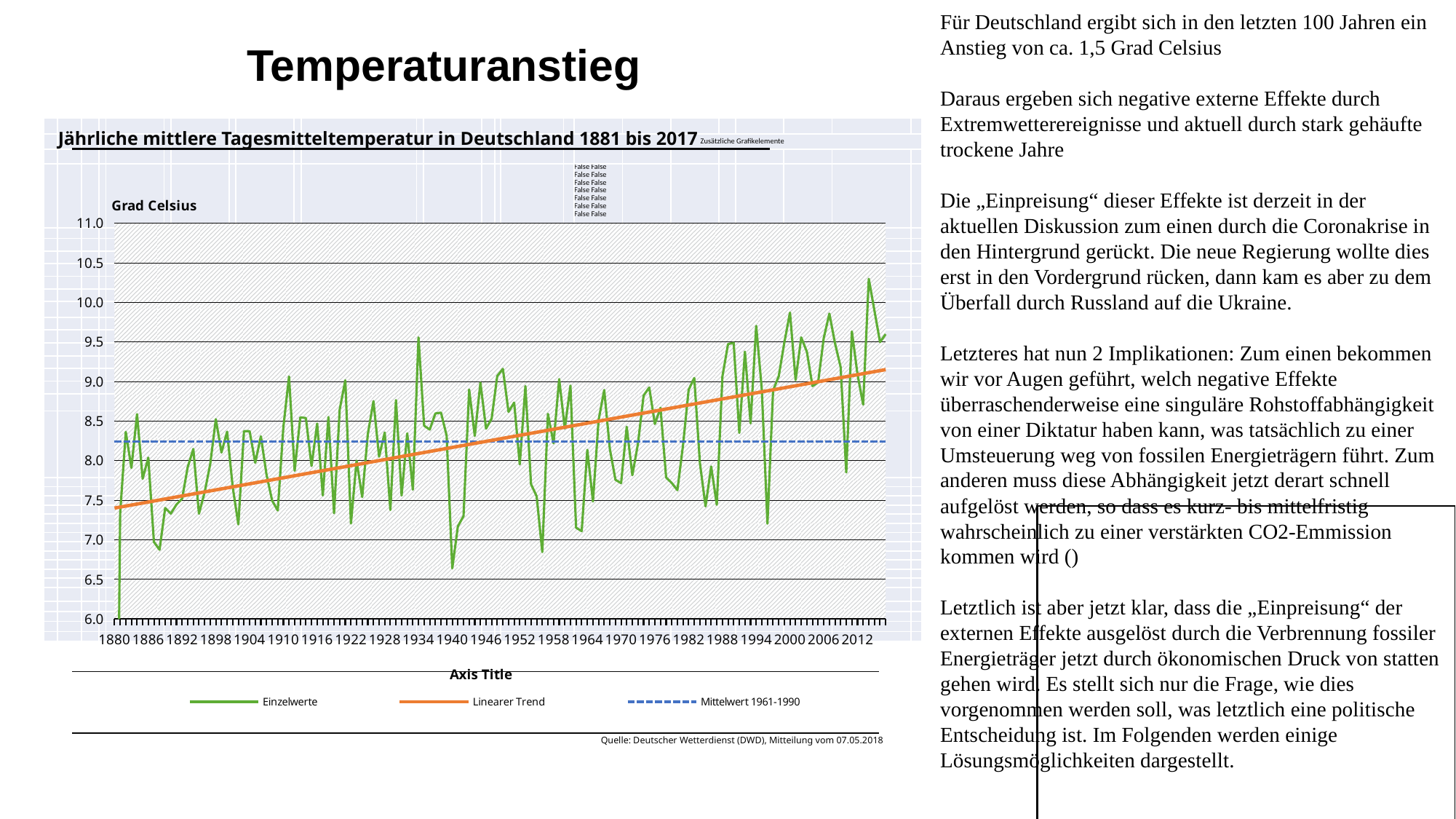
Is the highest 'Einzelwerte' value in the chart greater or less than 10.0? greater What is the title of the chart? Jährliche mittlere Tagesmitteltemperatur in Deutschland 1881 bis 2017 What kind of chart is shown on the slide? line chart What unit is shown as the label of the vertical axis? Grad Celsius Is the value of the 'Mittelwert 1961-1990' line greater or less than 8.5? less Is the 'Linearer Trend' value at the start of the series (around 1880) greater or less than 8.0? less What is the lowest value shown on the vertical axis of the chart? 6.0 Does the 'Linearer Trend' line rise or fall from 1880 to 2017? rise Which is larger: the 'Linearer Trend' value at the end of the series (around 2017) or the 'Mittelwert 1961-1990' value? Linearer Trend at the end of the series How many series does the legend of the chart list? 3